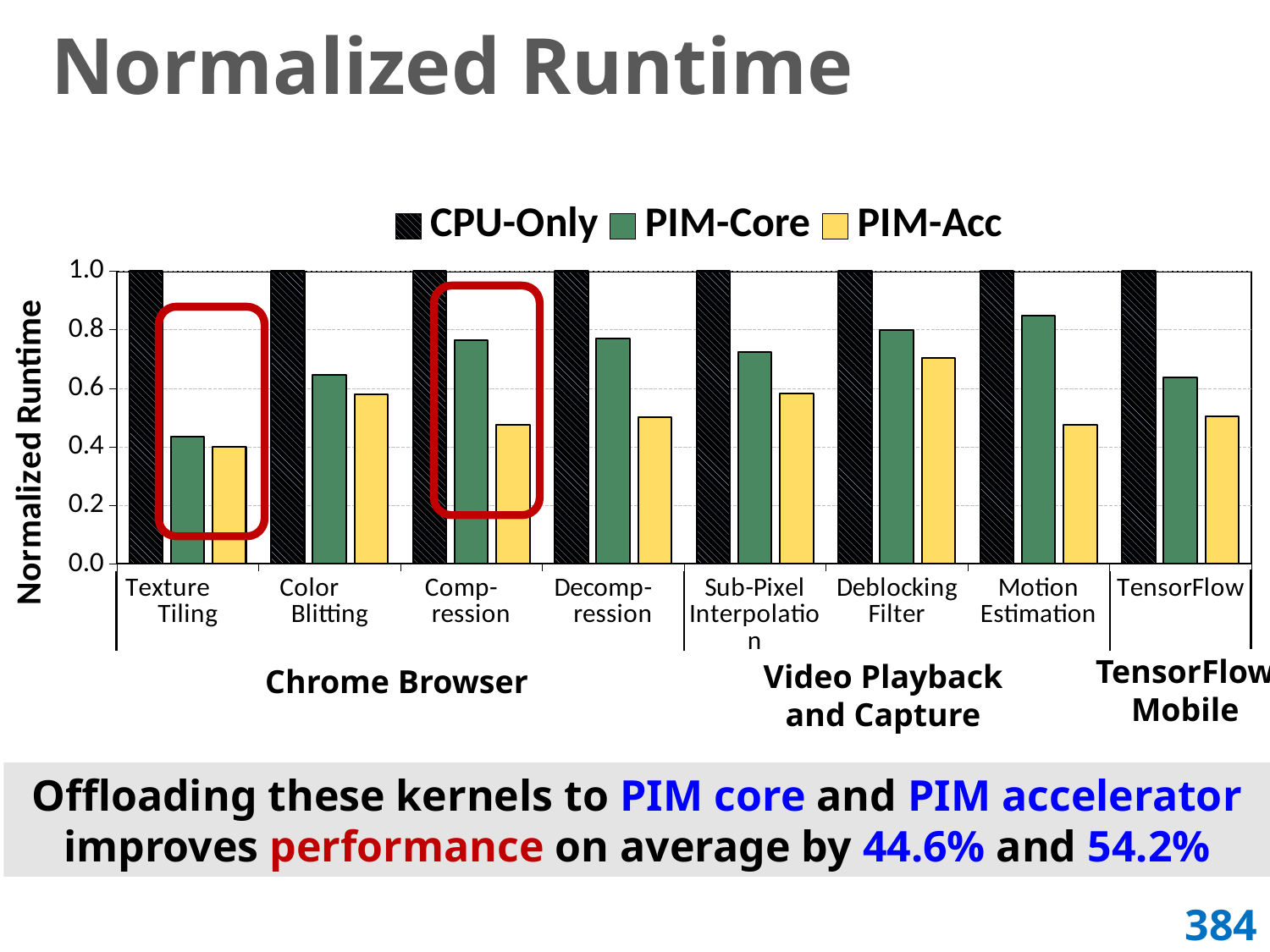
Which category has the highest PIM-Core normalized runtime? Motion Estimation What kind of chart is shown on the slide? bar chart What are the three series named in the legend? CPU-Only, PIM-Core, PIM-Acc How many kernel categories are plotted along the x axis? 8 Is the PIM-Core value for Motion Estimation greater or less than 0.6? greater For Compression, which is larger: the PIM-Core value or the PIM-Acc value? PIM-Core Which category has the lowest PIM-Acc normalized runtime? Texture Tiling How many series does the legend list? 3 Is the PIM-Acc value for Texture Tiling greater or less than 0.6? less What is the CPU-Only normalized runtime for Texture Tiling? 1.0 What is the label on the y axis? Normalized Runtime Is the PIM-Core value for Color Blitting greater or less than 0.8? less